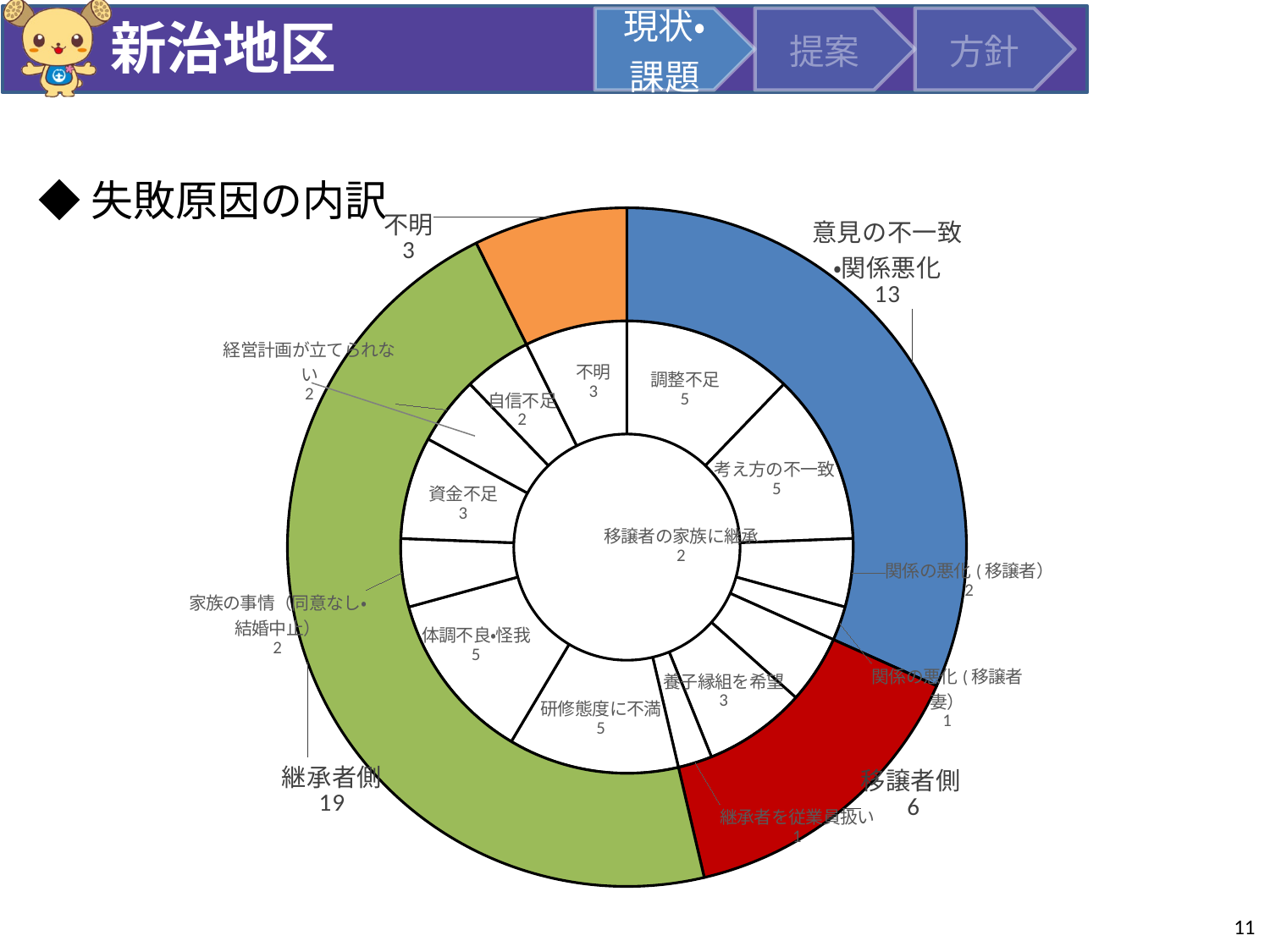
Which is larger, 移譲者側 or 不明? 移譲者側 Which category in the outer ring has the highest value? 継承者側 Which category in the outer ring has the lowest value? 不明 What is the value for 研修態度に不満 in the inner ring? 5 What is the value for 意見の不一致・関係悪化 in the outer ring? 13 What is the total of the four outer-ring categories? 41 What is the value for 継承者側 in the outer ring? 19 What kind of chart is shown on the slide? Doughnut chart What is the difference between 継承者側 and 意見の不一致・関係悪化 in the outer ring? 6 How many categories are in the outer ring? 4 What is the value for 移譲者側 in the outer ring? 6 What is the title of the chart? 失敗原因の内訳